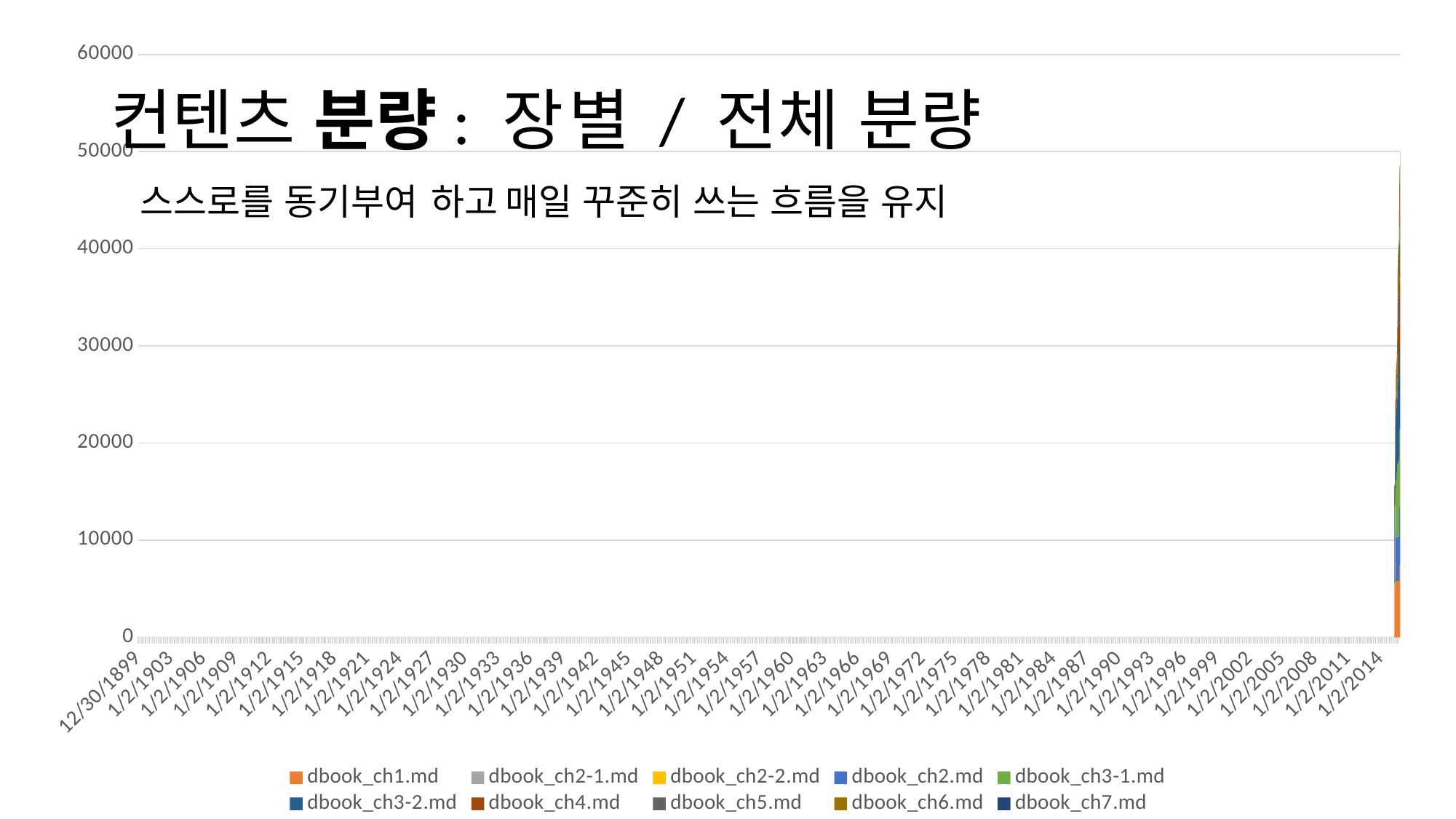
How many series does the chart legend list? 10 At the rightmost point of the chart, is the stacked total of all series greater or less than 30000? greater What is the first series listed in the chart legend? dbook_ch1.md What is the highest value shown on the chart's vertical axis? 60000 At the rightmost point of the chart, is the value for dbook_ch1.md greater or less than 10000? less